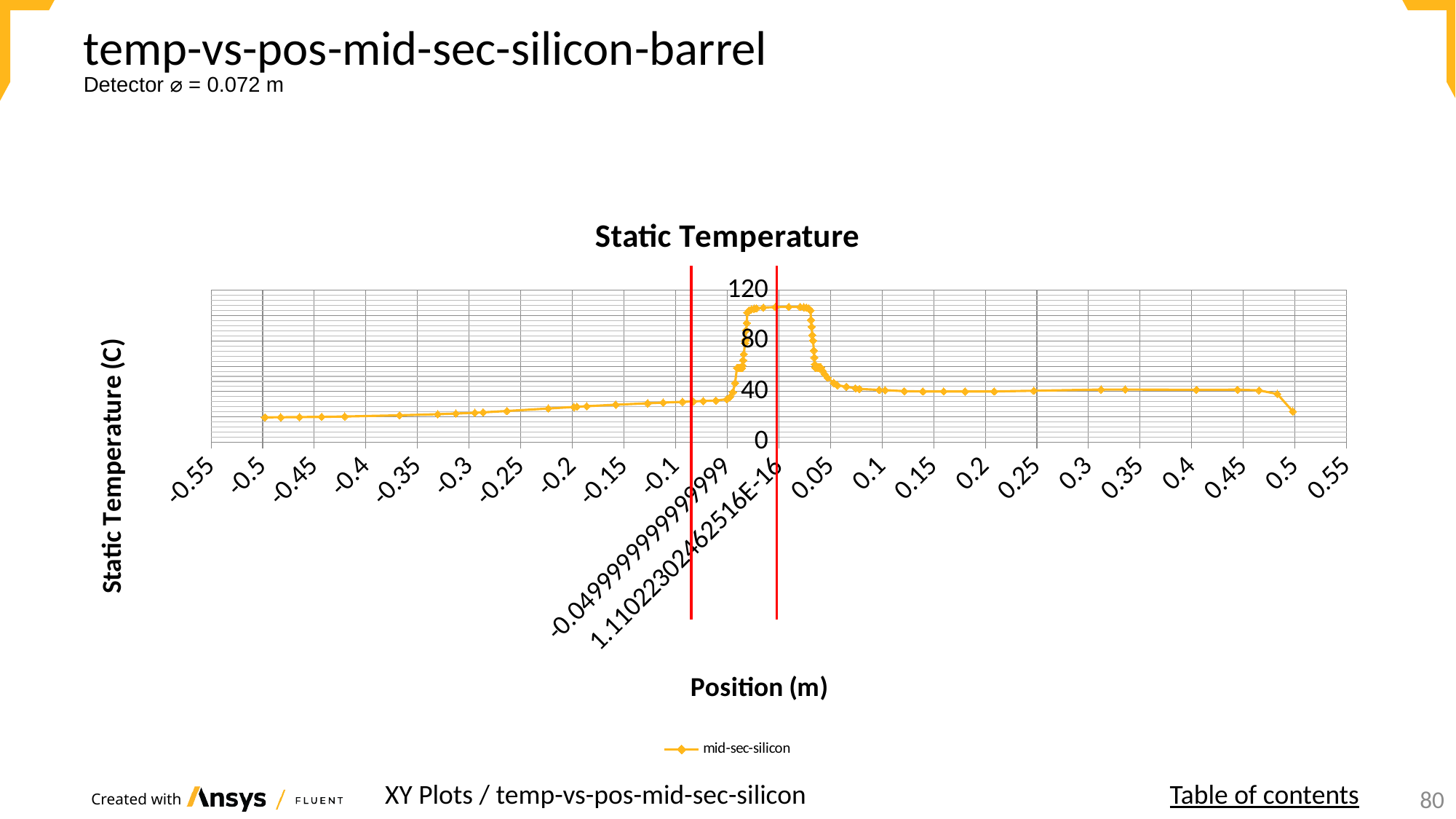
What is the title of the chart? Static Temperature Which is larger, the value at position 0.05 or the value at position -0.5? 0.05 Is the value for position -0.5 greater or less than 40? less What kind of chart is shown on the slide? line chart How many series does the legend list? 1 Do the values rise or fall along the x axis between position 0.05 and position 0.1? fall Is the value for position 0.05 greater or less than 80? less Is the value for position 0.5 greater or less than 40? less Do the values rise or fall along the x axis between position -0.5 and position -0.1? rise What is the name of the series shown in the legend? mid-sec-silicon